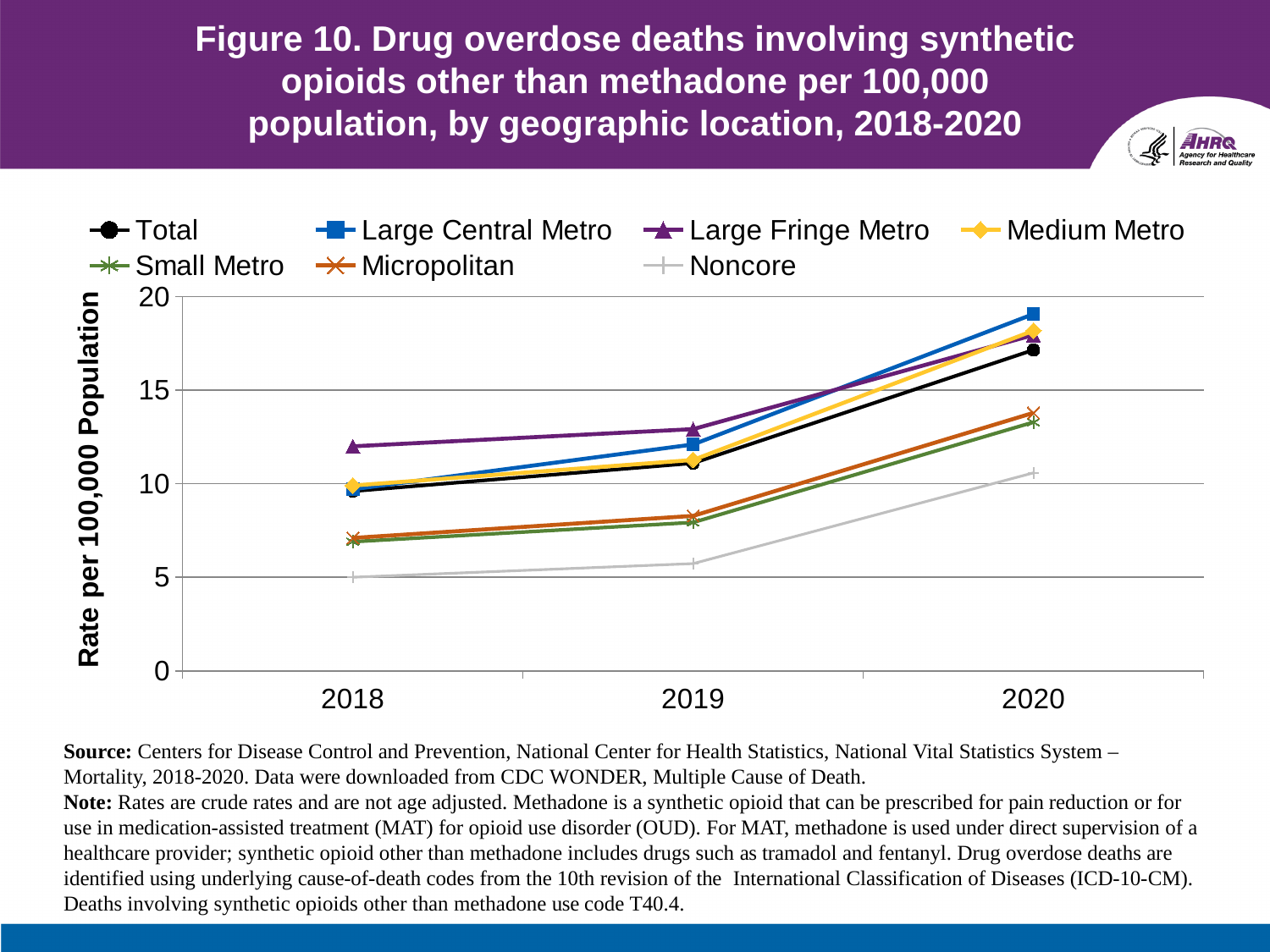
Which geographic location had the highest rate in 2020? Large Central Metro Is the Noncore rate in 2018 greater or less than 10? less Is the Noncore rate in 2020 greater or less than 15? less What is the label on the y axis? Rate per 100,000 Population Is the Large Central Metro rate in 2020 greater or less than 15? greater How many years are shown along the x axis? 3 Which geographic location had the lowest rate in 2020? Noncore How many series does the legend list? 7 What kind of chart is shown on the slide? line chart Which geographic location had the highest rate in 2018? Large Fringe Metro In 2019, which had the higher rate: Large Fringe Metro or Noncore? Large Fringe Metro Does the Total rate rise or fall from 2018 to 2020? rise